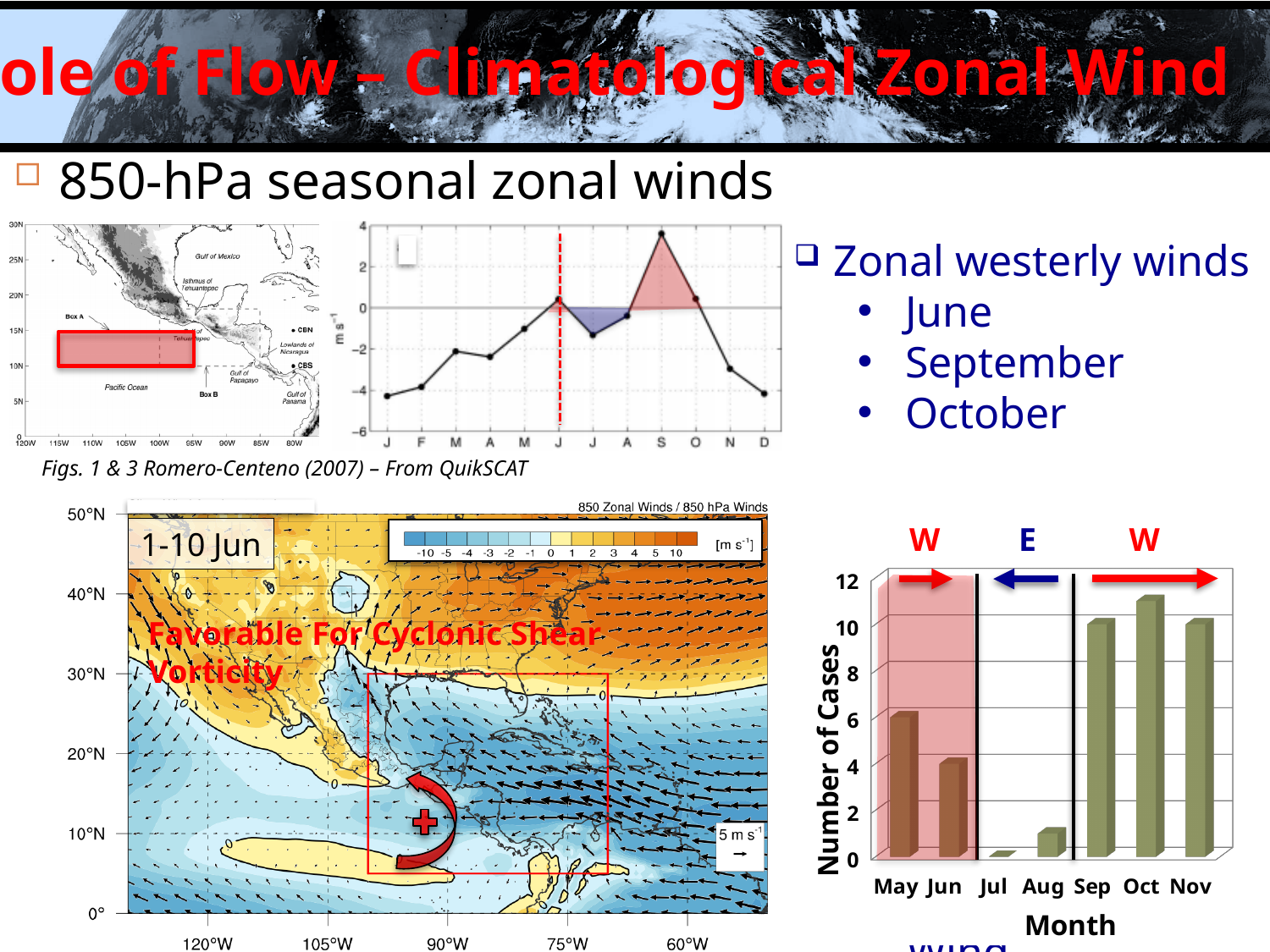
On the line chart at the top (zonal wind by month, m s-1), is the value for S greater or less than 2? greater On the bar chart at the bottom right (Number of Cases by Month), how many months are shown on the x axis? 7 On the bar chart at the bottom right (Number of Cases by Month), is the number of cases for Aug greater or less than 2? less On the bar chart at the bottom right (Number of Cases by Month), is the number of cases for Jun greater or less than 6? less On the line chart at the top (zonal wind by month, m s-1), in which month does the line reach its highest value? S On the bar chart at the bottom right (Number of Cases by Month), which month has the highest number of cases? Oct On the bar chart at the bottom right (Number of Cases by Month), what kind of chart is it? bar chart On the bar chart at the bottom right (Number of Cases by Month), which has more cases, Sep or Jun? Sep On the bar chart at the bottom right (Number of Cases by Month), which month has the lowest number of cases? Jul On the bar chart at the bottom right (Number of Cases by Month), which has more cases, May or Jun? May On the bar chart at the bottom right, what is the label of the y axis? Number of Cases